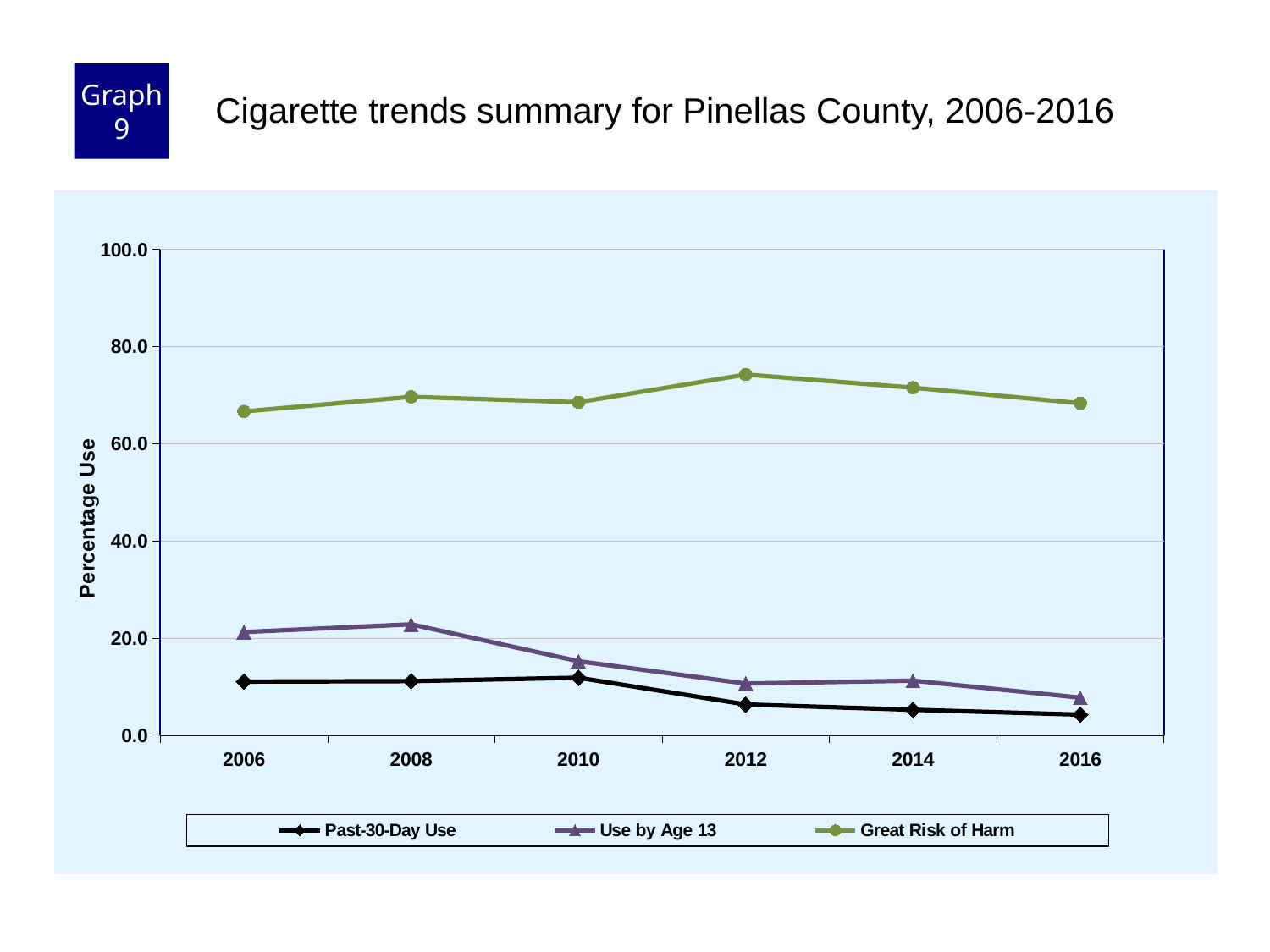
Does the Past-30-Day Use series rise or fall from 2010 to 2016? fall In which year is the Use by Age 13 series at its lowest? 2016 How many years are plotted along the x axis? 6 How many series does the legend list? 3 What kind of chart is shown on the slide? Line chart Is the value for Great Risk of Harm in 2012 greater or less than 80? less What is the title of the y axis? Percentage Use In which year is the Great Risk of Harm series at its highest? 2012 Is the value for Great Risk of Harm in 2006 greater or less than 60? greater Is the value for Use by Age 13 in 2008 greater or less than 20? greater In 2006, which is larger: Use by Age 13 or Past-30-Day Use? Use by Age 13